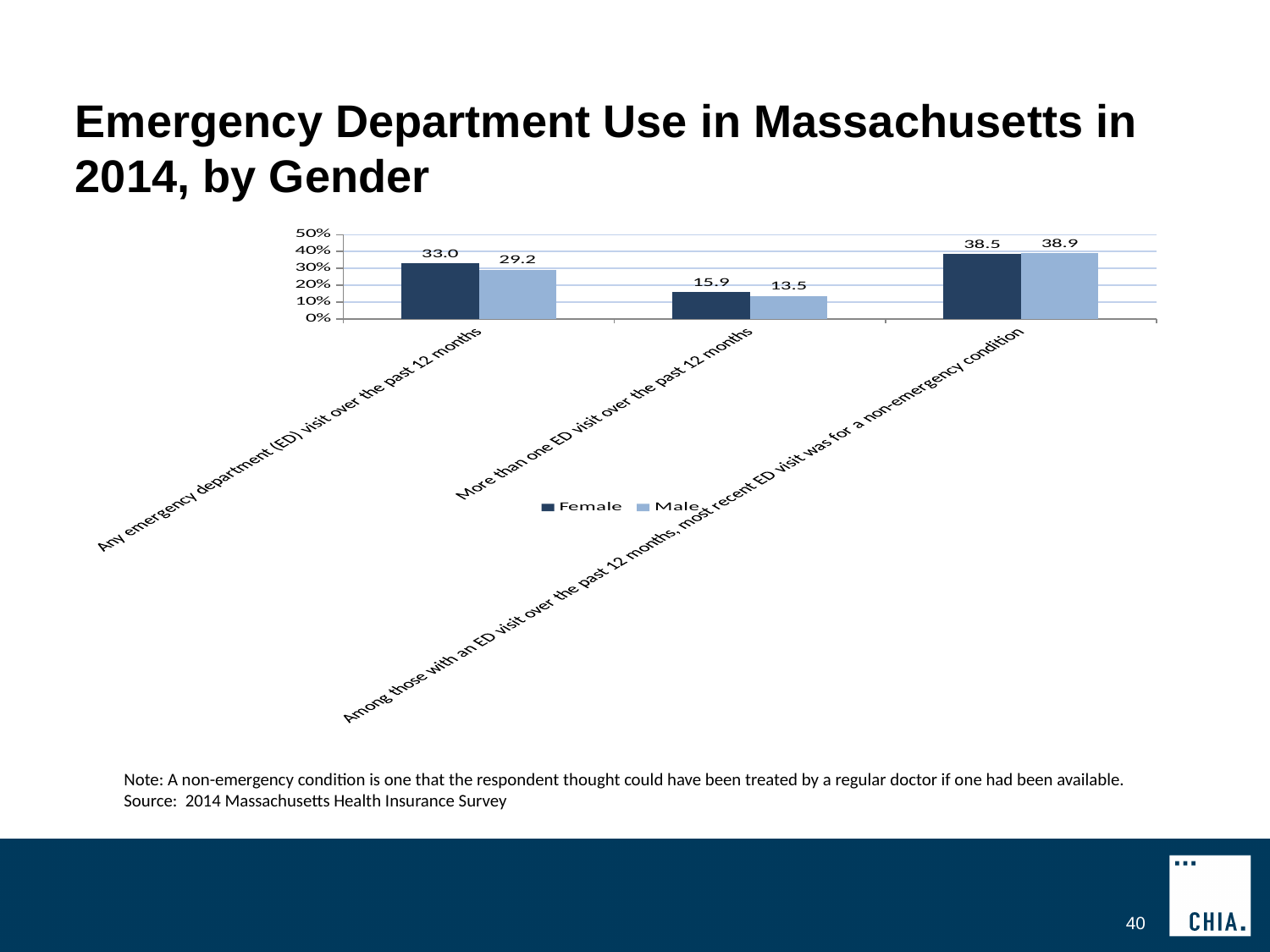
Which category has the lowest Male value? More than one ED visit over the past 12 months Is the Female value for 'More than one ED visit over the past 12 months' greater or less than 20%? less Which series is shown in the darker blue colour? Female How many categories are shown on the x axis? 3 What is the difference between the Female and Male values for 'Any emergency department (ED) visit over the past 12 months'? 3.8 What is the Male value for 'Among those with an ED visit over the past 12 months, most recent ED visit was for a non-emergency condition'? 38.9 For 'More than one ED visit over the past 12 months', which is larger, the Female or the Male value? Female What is the Male value for 'More than one ED visit over the past 12 months'? 13.5 What kind of chart is shown on the slide? bar chart How many series does the legend list? 2 What is the Female value for 'Any emergency department (ED) visit over the past 12 months'? 33.0 Which category has the highest Female value? Among those with an ED visit over the past 12 months, most recent ED visit was for a non-emergency condition